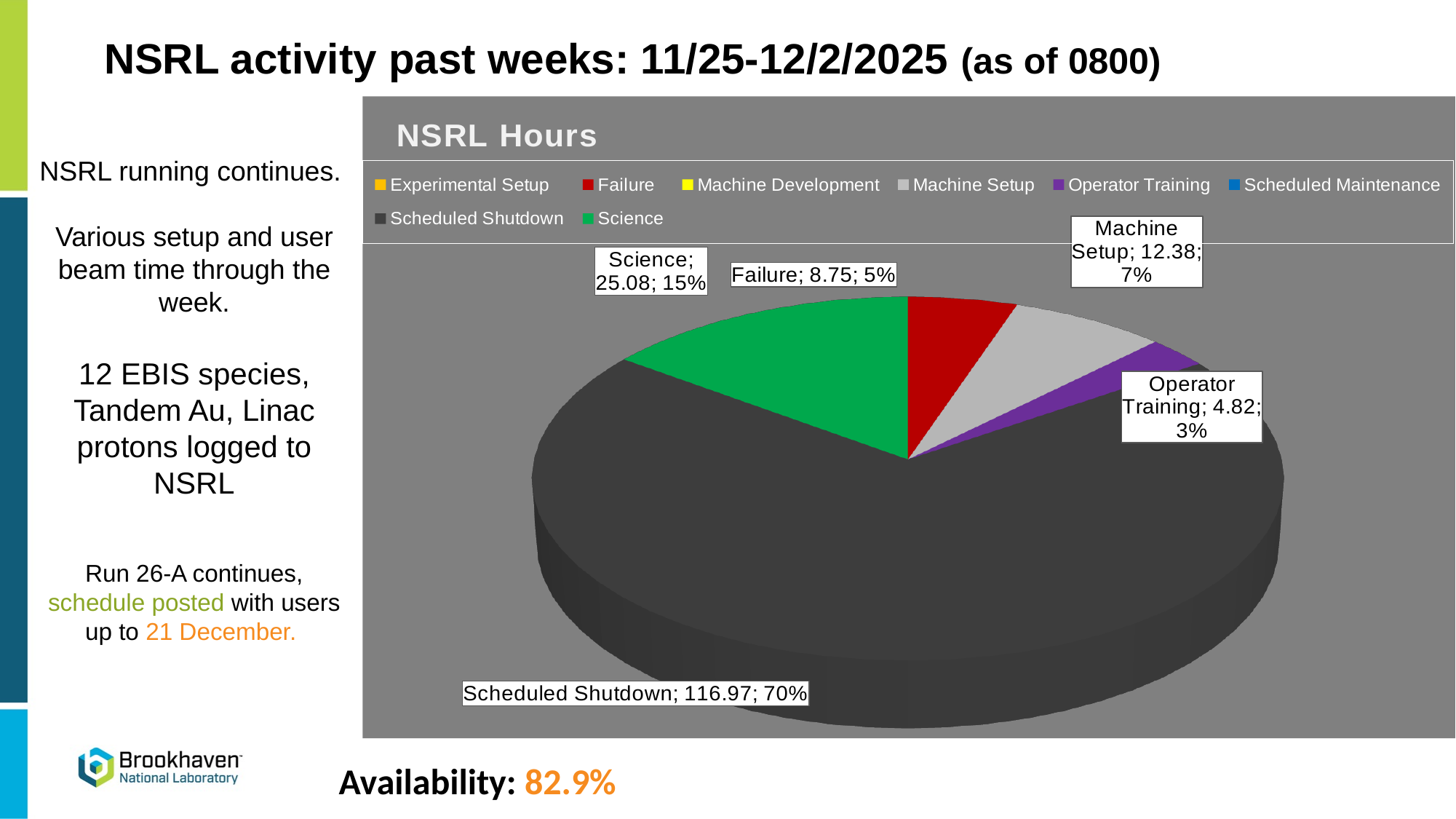
What percentage share of the pie does Failure have? 5% How many slices of the pie have data labels? 5 How many entries does the chart legend list? 8 What is the difference in hours between Science and Failure? 16.33 How many hours are labeled for Machine Setup? 12.38 Which category has the largest slice of the pie? Scheduled Shutdown Among the labeled slices, which category has the fewest hours? Operator Training What percentage share of the pie does Operator Training have? 3% How many hours are labeled for Scheduled Shutdown? 116.97 How many hours are labeled for Science? 25.08 What is the title of the chart? NSRL Hours What type of chart is shown on the slide? pie chart